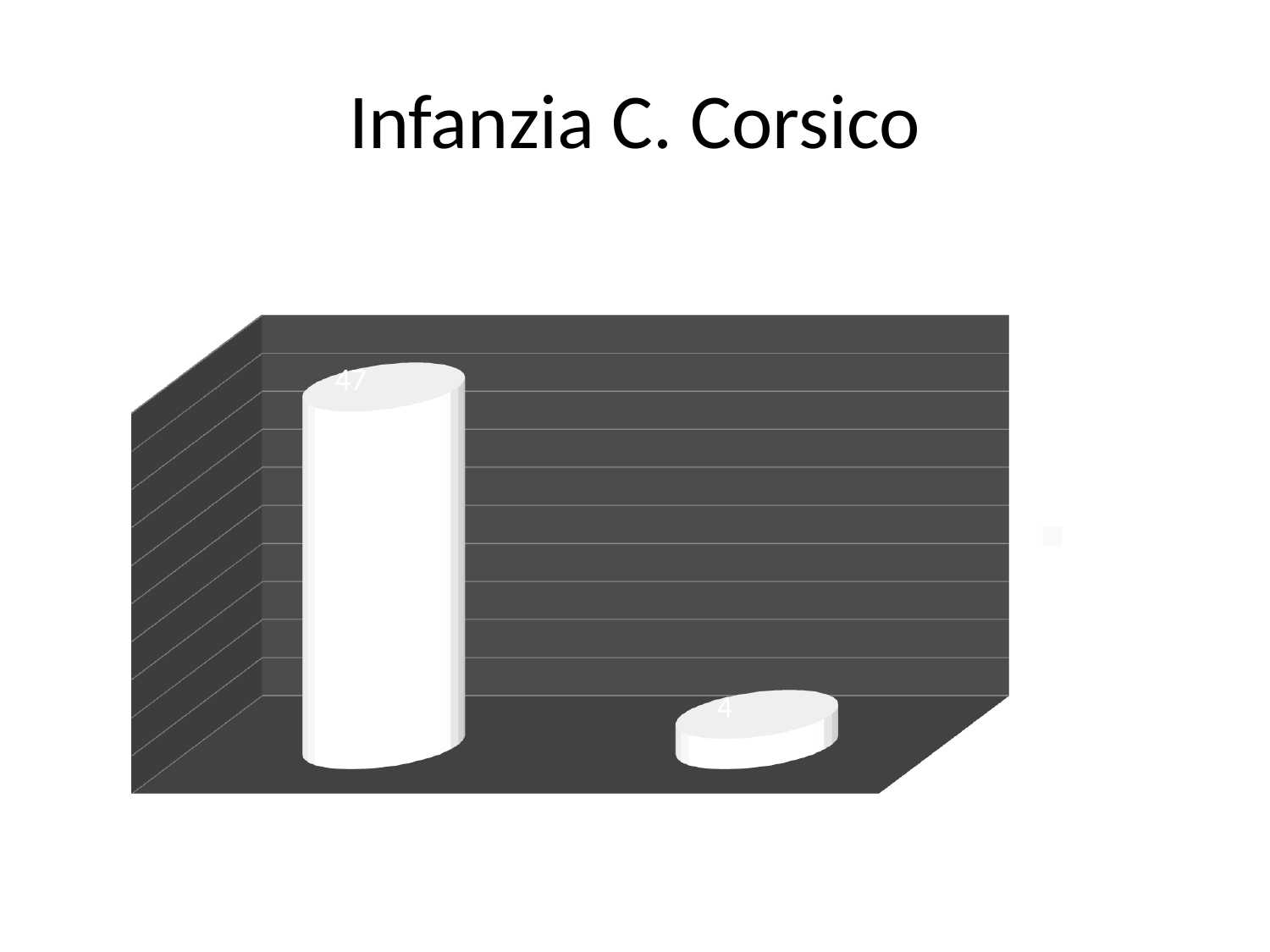
How many bars are plotted on the chart? 2 What is the lowest value plotted on the chart? 4 What is the difference between the left bar's value and the right bar's value? 43 What is the value shown on the left bar of the chart? 47 What is the highest value plotted on the chart? 47 Which bar has the higher value, the left one or the right one? the left one Do the values fall or rise from the left bar to the right bar? fall What is the title of the slide containing the chart? Infanzia C. Corsico What is the value shown on the right bar of the chart? 4 What kind of chart is shown on the slide? bar chart